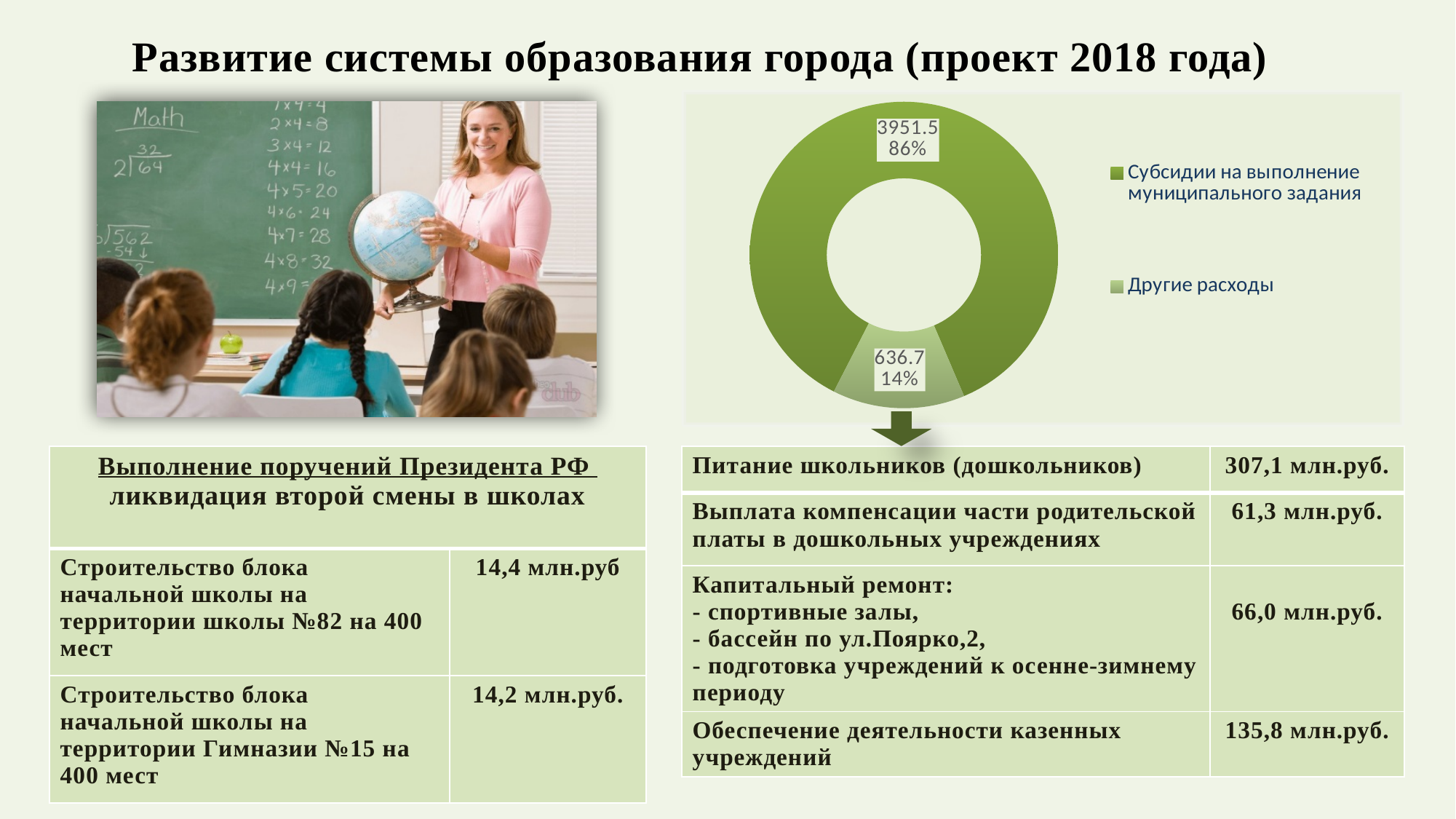
What value is shown for Субсидии на выполнение муниципального задания in the doughnut chart? 3951.5 What share of the doughnut chart does Другие расходы represent? 14% What share of the doughnut chart does Субсидии на выполнение муниципального задания represent? 86% What value is shown for Другие расходы in the doughnut chart? 636.7 Which category in the doughnut chart has the largest value? Субсидии на выполнение муниципального задания How many entries does the legend of the doughnut chart list? 2 What type of chart is shown on the slide? Doughnut chart How many categories does the doughnut chart show? 2 Which category in the doughnut chart has the smallest value? Другие расходы Which is larger in the doughnut chart: Субсидии на выполнение муниципального задания or Другие расходы? Субсидии на выполнение муниципального задания What is the difference between the values for Субсидии на выполнение муниципального задания and Другие расходы in the doughnut chart? 3314.8 What is the total of the two values shown in the doughnut chart? 4588.2